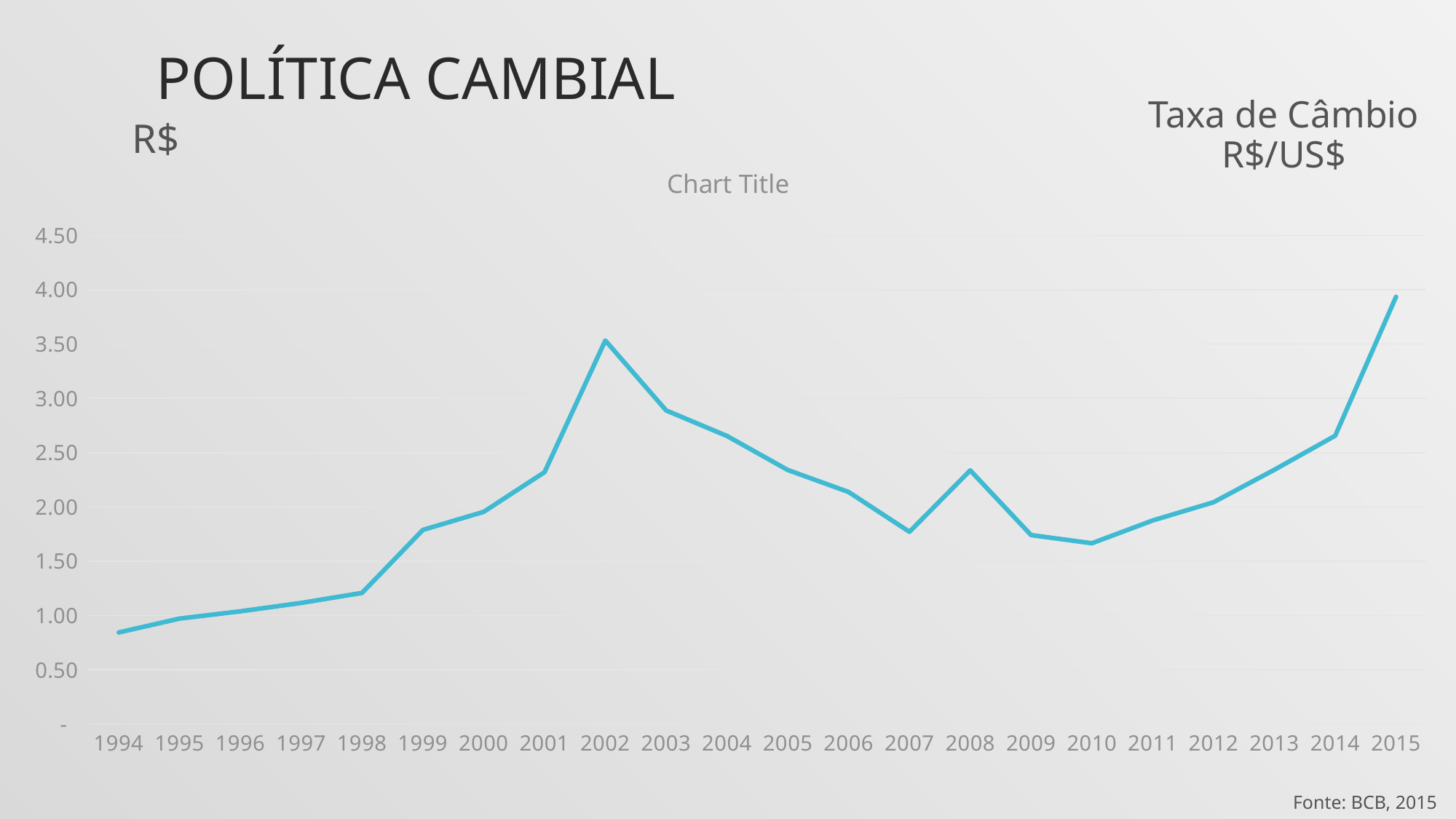
What kind of chart is shown on the slide? line chart Is the value for 1994 greater or less than 1.00? less How many years are plotted along the x axis of the chart? 22 Which year has the lowest exchange rate value on the chart? 1994 Is the value for 2010 greater or less than 2.00? less Which year has the highest exchange rate value on the chart? 2015 What source is cited at the bottom of the slide? Fonte: BCB, 2015 Does the line rise or fall from 1994 to 2002? rise Which year has the larger value, 2002 or 2008? 2002 Is the value for 2002 greater or less than 3.00? greater Which year has the larger value, 2003 or 2006? 2003